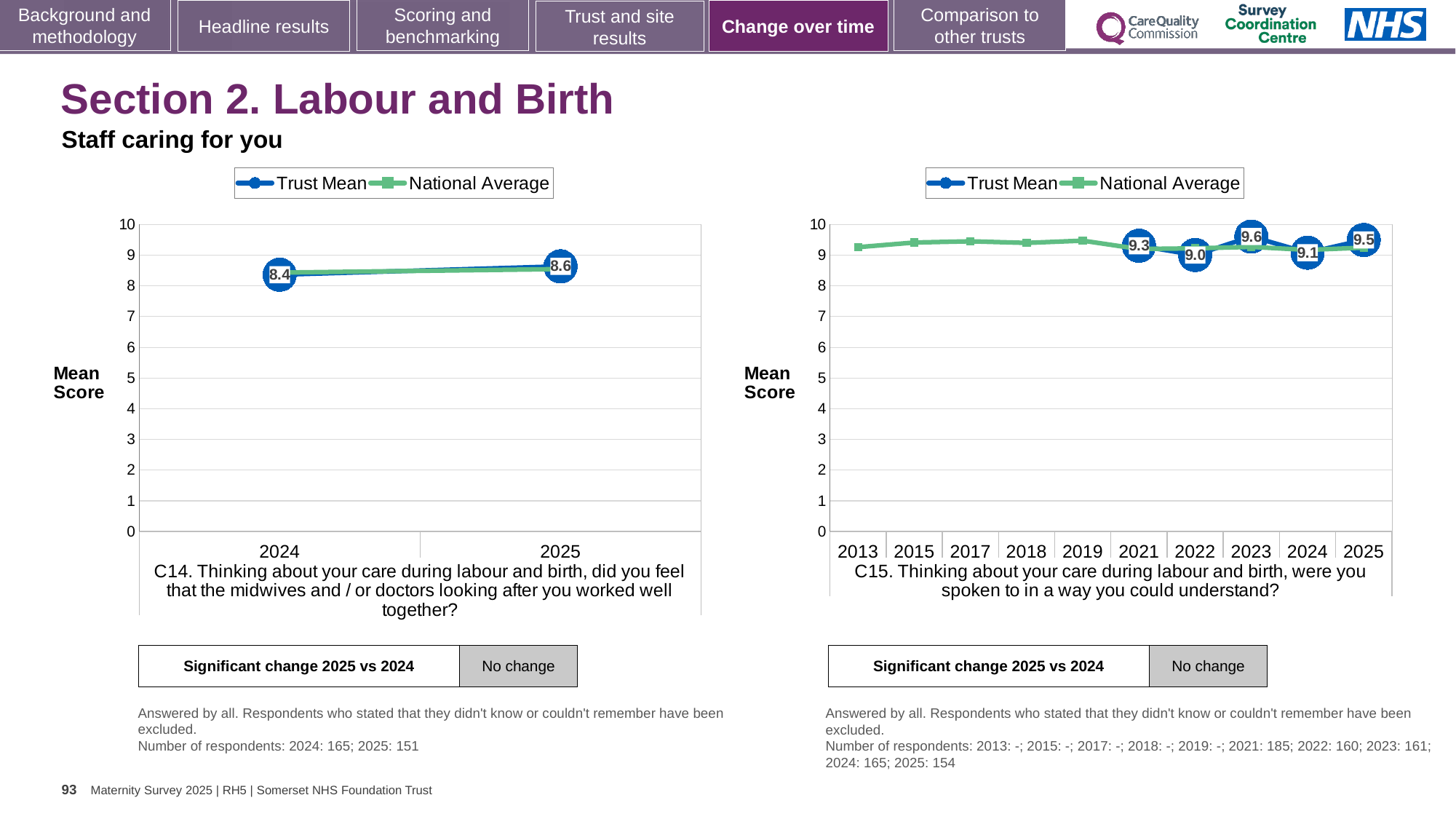
In the left chart (C14), what is the Trust Mean score for 2024? 8.4 In the left chart (C14), what is the Trust Mean score for 2025? 8.6 How many years are shown on the x axis of the right chart (C15)? 10 In the right chart (C15), what is the Trust Mean score for 2022? 9.0 In the right chart (C15), what is the Trust Mean score for 2023? 9.6 In the right chart (C15), which year has the highest Trust Mean score? 2023 What kind of chart is the left chart (C14)? line chart In the right chart (C15), what is the difference between the Trust Mean scores for 2025 and 2024? 0.4 In the left chart (C14), by how much did the Trust Mean change from 2024 to 2025? 0.2 How many series does the legend of the right chart (C15) list? 2 In the left chart (C14), does the Trust Mean rise or fall from 2024 to 2025? rise In the right chart (C15), which year has the lowest Trust Mean score? 2022